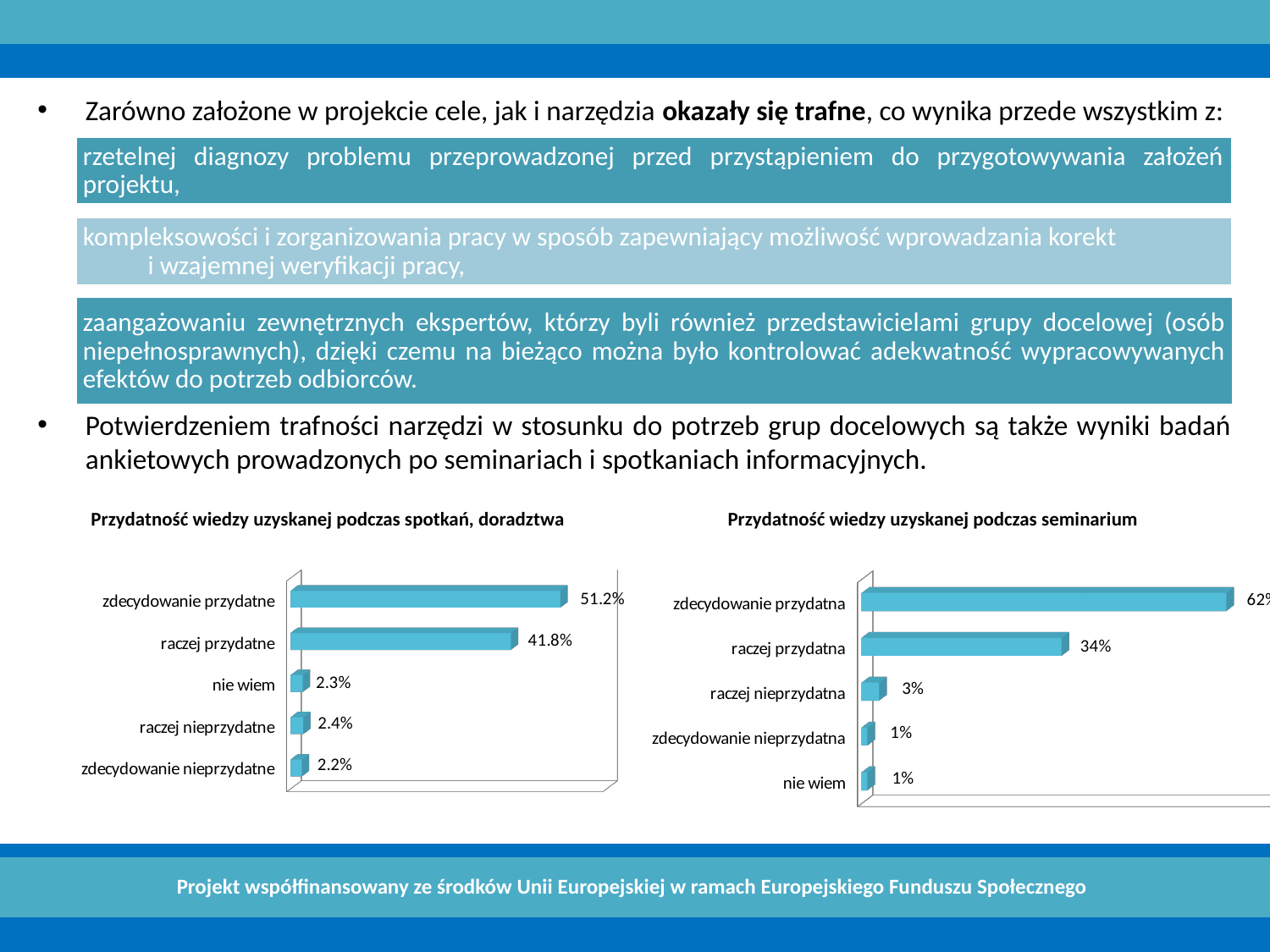
In the chart 'Przydatność wiedzy uzyskanej podczas spotkań, doradztwa', what is the difference between 'zdecydowanie przydatne' and 'raczej przydatne'? 9.4% In the chart 'Przydatność wiedzy uzyskanej podczas seminarium', what is the value for 'raczej nieprzydatna'? 3% In the chart 'Przydatność wiedzy uzyskanej podczas spotkań, doradztwa', what is the value for 'zdecydowanie przydatne'? 51.2% In the chart 'Przydatność wiedzy uzyskanej podczas seminarium', what is the difference between 'raczej przydatna' and 'raczej nieprzydatna'? 31% In the chart 'Przydatność wiedzy uzyskanej podczas seminarium', which category has the highest value? zdecydowanie przydatna In the chart 'Przydatność wiedzy uzyskanej podczas seminarium', what is the value for 'raczej przydatna'? 34% In the chart 'Przydatność wiedzy uzyskanej podczas seminarium', which is larger: 'raczej przydatna' or 'raczej nieprzydatna'? raczej przydatna In the chart 'Przydatność wiedzy uzyskanej podczas spotkań, doradztwa', how many categories are shown? 5 In the chart 'Przydatność wiedzy uzyskanej podczas spotkań, doradztwa', what is the value for 'nie wiem'? 2.3% What kind of chart is 'Przydatność wiedzy uzyskanej podczas spotkań, doradztwa'? bar chart In the chart 'Przydatność wiedzy uzyskanej podczas spotkań, doradztwa', what is the value for 'raczej przydatne'? 41.8% In the chart 'Przydatność wiedzy uzyskanej podczas spotkań, doradztwa', which category has the highest value? zdecydowanie przydatne